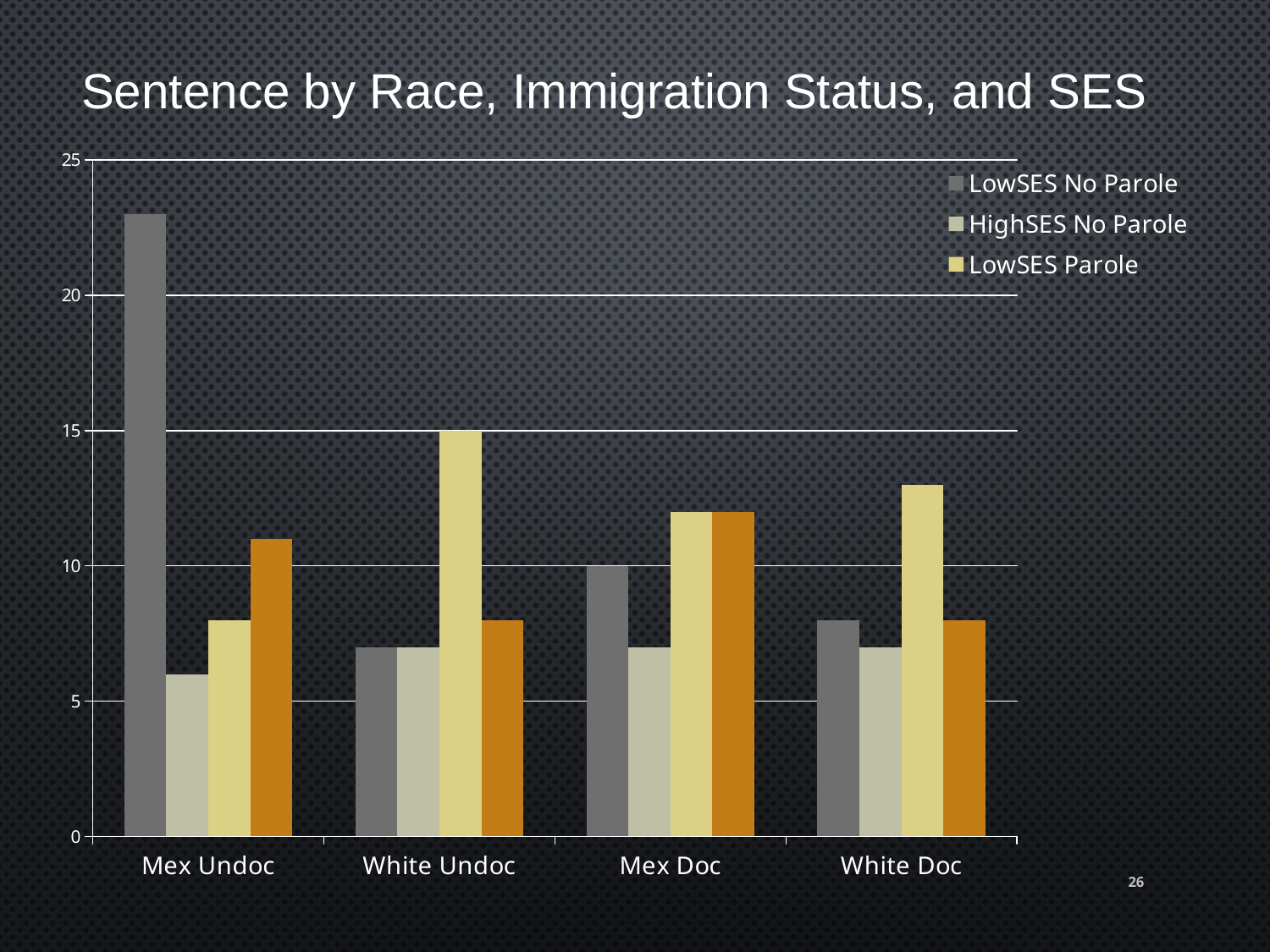
What kind of chart is shown on the slide? bar chart What is the LowSES Parole value for White Undoc? 15 How many series does the legend list? 3 Which category has the highest LowSES Parole value? White Undoc Which category has the highest LowSES No Parole value? Mex Undoc Is the HighSES No Parole value for Mex Undoc greater or less than 10? less How many categories are shown on the x axis? 4 What is the title of the chart? Sentence by Race, Immigration Status, and SES Is the LowSES Parole value for White Doc greater or less than 10? greater Which is larger, the LowSES No Parole value for Mex Undoc or for White Undoc? Mex Undoc What is the LowSES No Parole value for Mex Doc? 10 Is the LowSES No Parole value for Mex Undoc greater or less than 20? greater